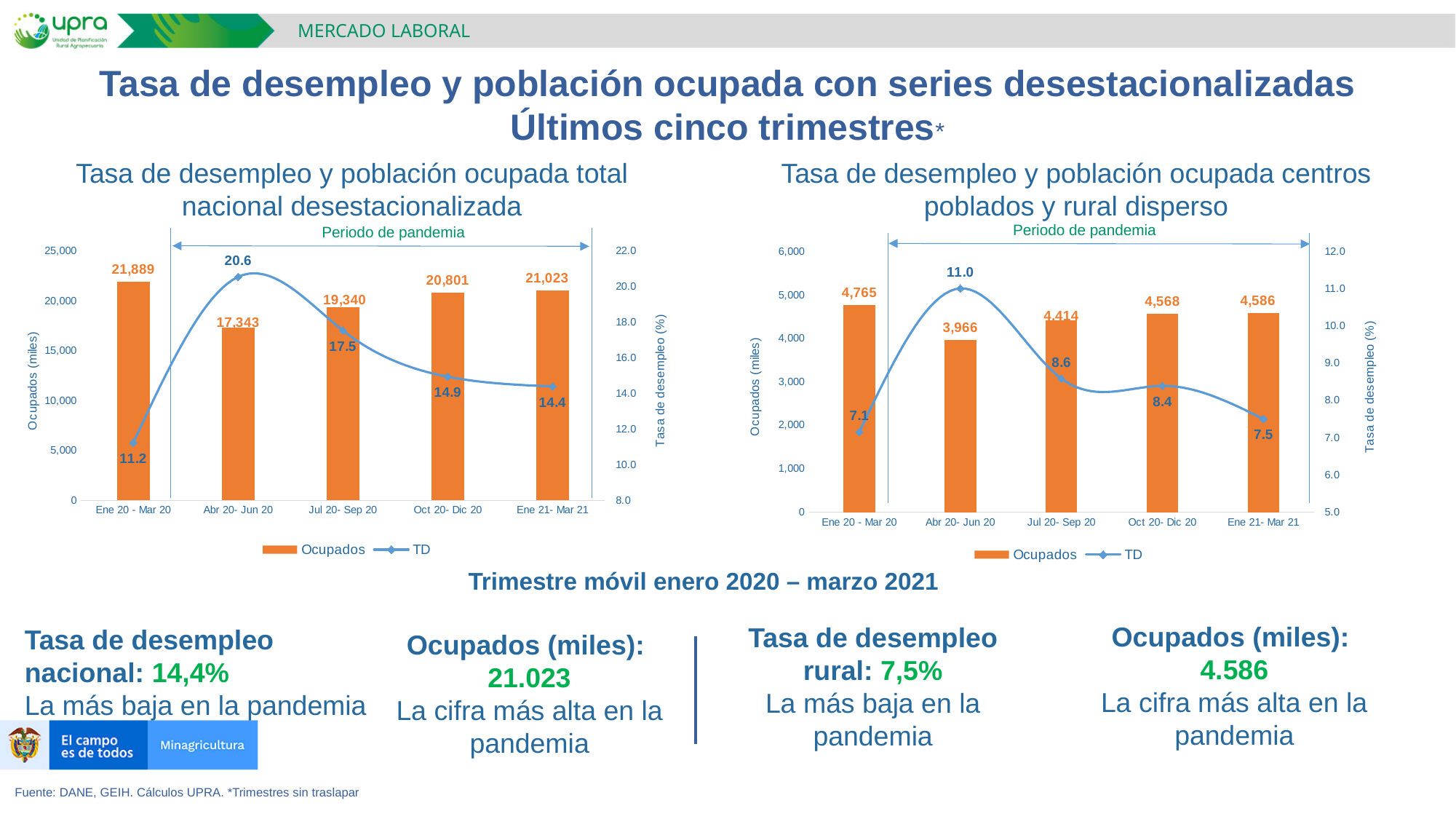
In the left chart (total nacional desestacionalizada), does the TD line rise or fall from Abr 20- Jun 20 to Ene 21- Mar 21? fall In the left chart (total nacional desestacionalizada), what is the difference in Ocupados between Ene 20 - Mar 20 and Abr 20- Jun 20? 4,546 In the right chart (centros poblados y rural disperso), how many periods are shown on the x axis? 5 In the right chart (centros poblados y rural disperso), what is the Ocupados value for Ene 21- Mar 21? 4,586 In the left chart (total nacional desestacionalizada), how many series does the legend list? 2 In the right chart (centros poblados y rural disperso), which period has the highest TD value? Abr 20- Jun 20 In the right chart (centros poblados y rural disperso), what is the TD value for Jul 20- Sep 20? 8.6 In the left chart (total nacional desestacionalizada), what is the TD value for Abr 20- Jun 20? 20.6 In the left chart (total nacional desestacionalizada), which period has the lowest Ocupados value? Abr 20- Jun 20 In the left chart (total nacional desestacionalizada), what is the Ocupados value for Ene 20 - Mar 20? 21,889 In the right chart (centros poblados y rural disperso), is the Ocupados value for Ene 20 - Mar 20 larger than for Oct 20- Dic 20? Yes, Ene 20 - Mar 20 What type of chart is used for the Ocupados series in the right chart (centros poblados y rural disperso)? Bar chart